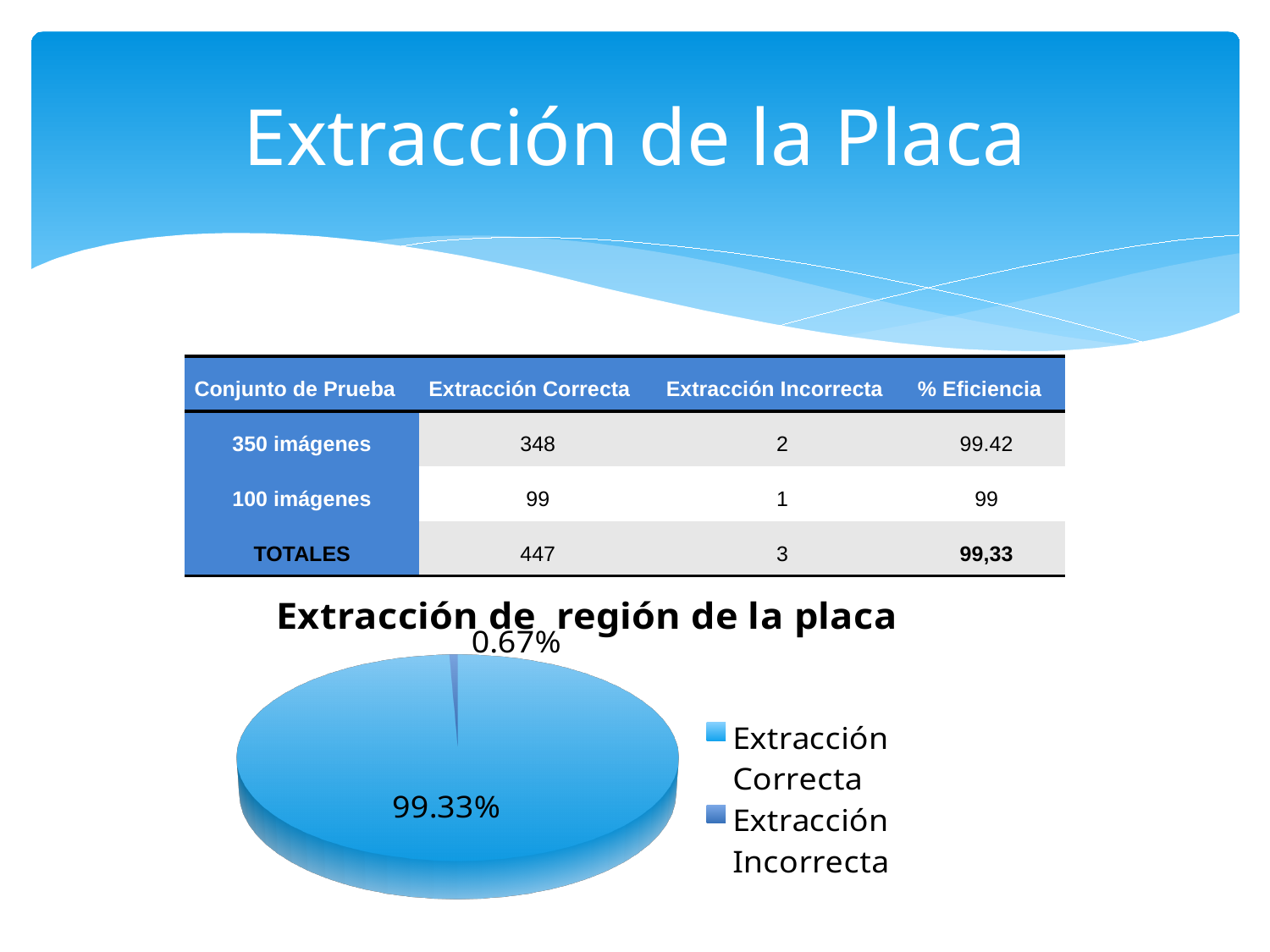
What is the chart's title? Extracción de región de la placa Is the share for Extracción Incorrecta greater or less than 1%? less How many entries does the legend list? 2 What kind of chart is shown on the slide? pie chart Which slice of the pie is the largest? Extracción Correcta What share of the pie does Extracción Correcta take? 99.33% What is the difference in percentage points between the Extracción Correcta and Extracción Incorrecta slices? 98.66 What share of the pie does Extracción Incorrecta take? 0.67% How many slices does the pie chart have? 2 Which is larger, the Extracción Correcta slice or the Extracción Incorrecta slice? Extracción Correcta Which slice of the pie is the smallest? Extracción Incorrecta